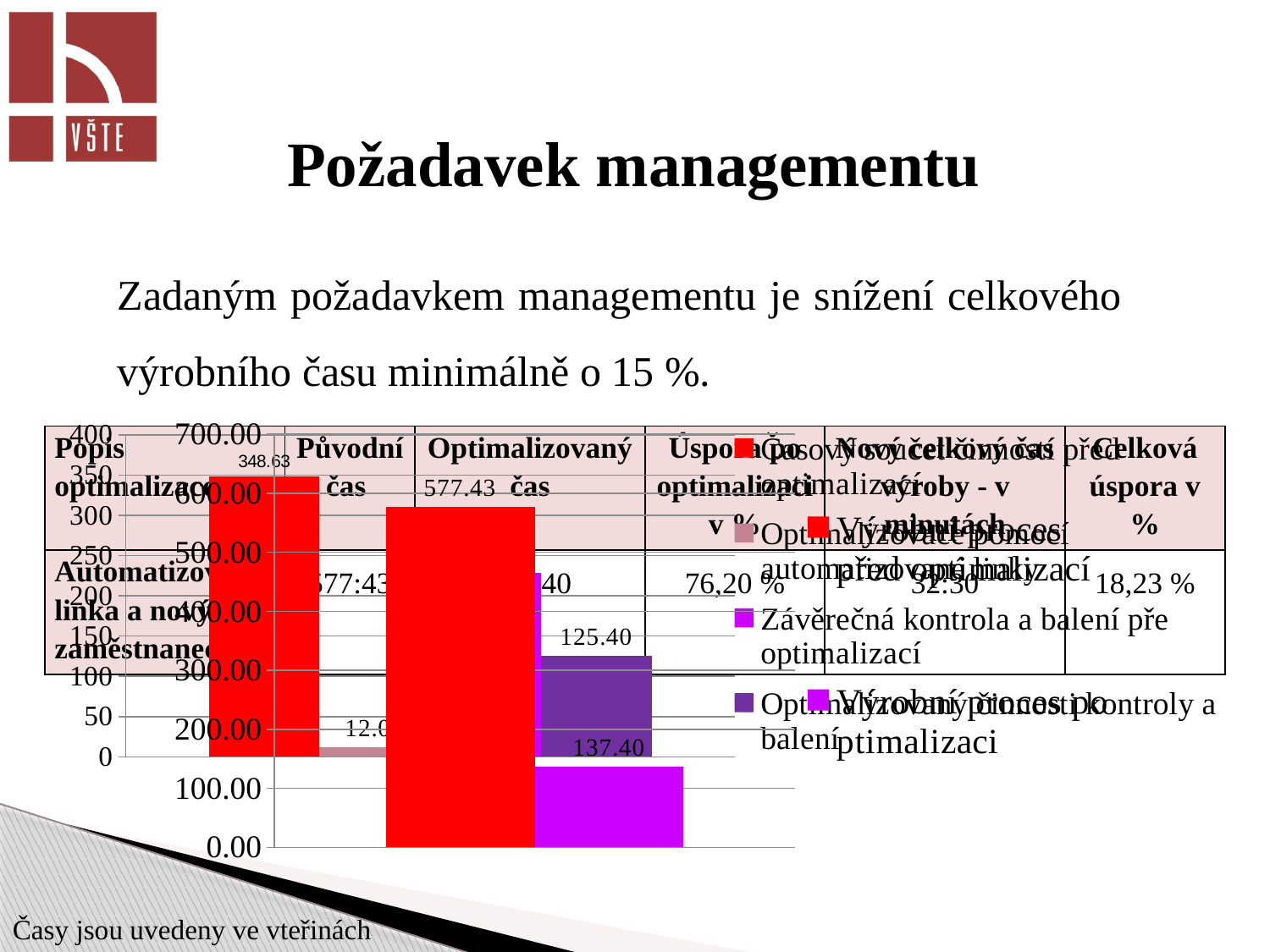
In the chart with the 0.00–700.00 axis, is the value of the red bar greater or less than 500.00? greater In the chart with the 0.00–700.00 axis, which bar is the lowest? the magenta bar (137.40) In the chart with the 0.00–700.00 axis, what is the difference between the red bar (577.43) and the magenta bar (137.40)? 440.03 In the chart with the 0.00–700.00 axis, which bar is the highest? the red bar (577.43) In the chart with the 0.00–700.00 axis, what value is printed on the magenta bar? 137.40 In the chart with the 0–400 axis, what value is printed on the tall red bar? 348.63 What is the highest tick value on the y axis of the chart with the 0.00–700.00 axis? 700.00 In the chart with the 0.00–700.00 axis, what value is printed on the tall red bar? 577.43 What kind of chart is shown on the slide? bar chart